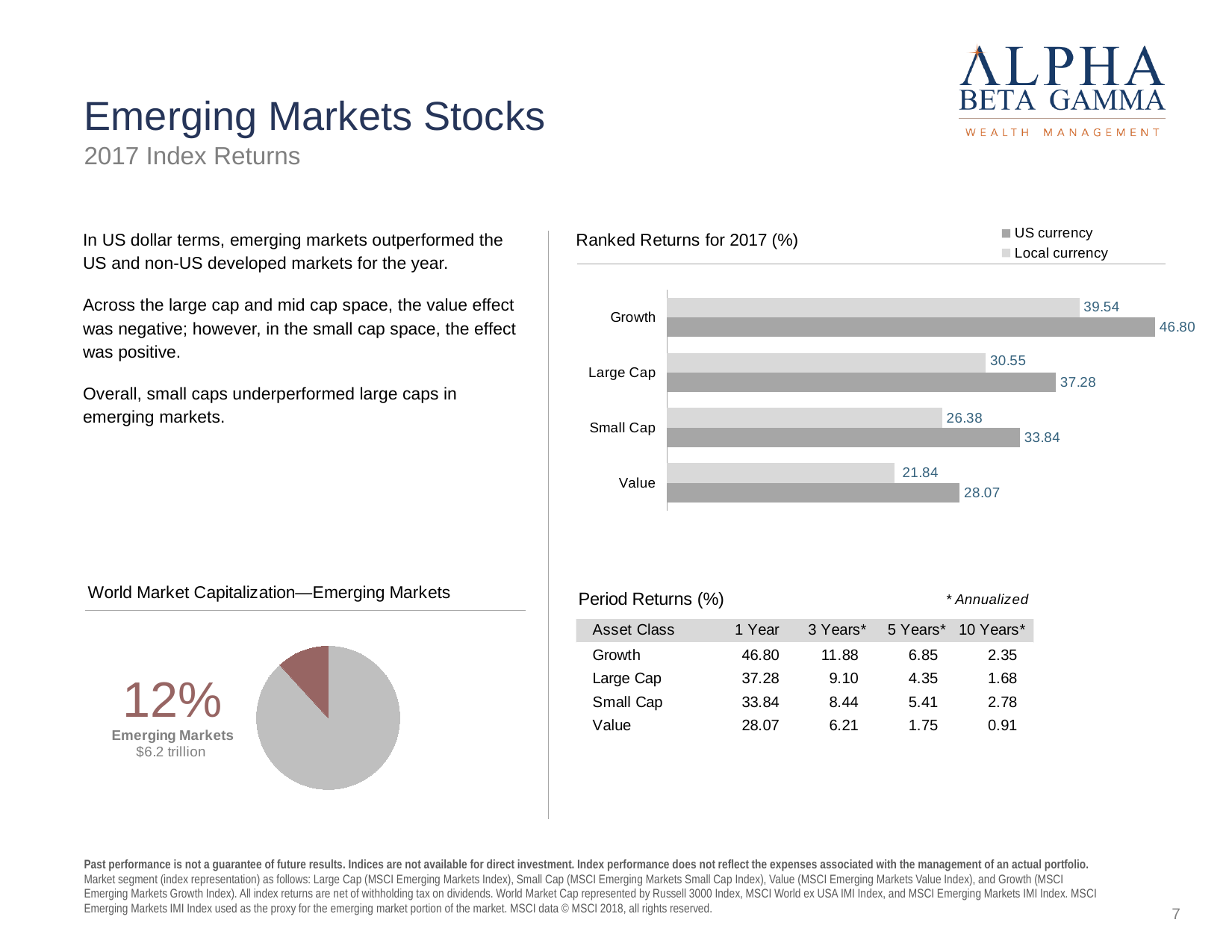
In the Ranked Returns for 2017 (%) chart, what is the Local currency return for Small Cap? 26.38 What kind of chart is the Ranked Returns for 2017 (%) chart? Bar chart In the Ranked Returns for 2017 (%) chart, which is larger: the US currency return for Small Cap or the Local currency return for Growth? Local currency return for Growth In the Ranked Returns for 2017 (%) chart, what is the US currency return for Growth? 46.80 In the World Market Capitalization—Emerging Markets pie chart, what share of world market capitalization do Emerging Markets represent? 12% In the Ranked Returns for 2017 (%) chart, which category has the highest US currency return? Growth How many categories are shown in the Ranked Returns for 2017 (%) chart? 4 In the Ranked Returns for 2017 (%) chart, which category has the lowest Local currency return? Value In the Ranked Returns for 2017 (%) chart, what is the difference between the US currency and Local currency returns for Large Cap? 6.73 In the Ranked Returns for 2017 (%) chart, what is the Local currency return for Value? 21.84 How many series does the legend of the Ranked Returns for 2017 (%) chart list? 2 In the World Market Capitalization—Emerging Markets pie chart, what dollar value is shown for Emerging Markets? $6.2 trillion